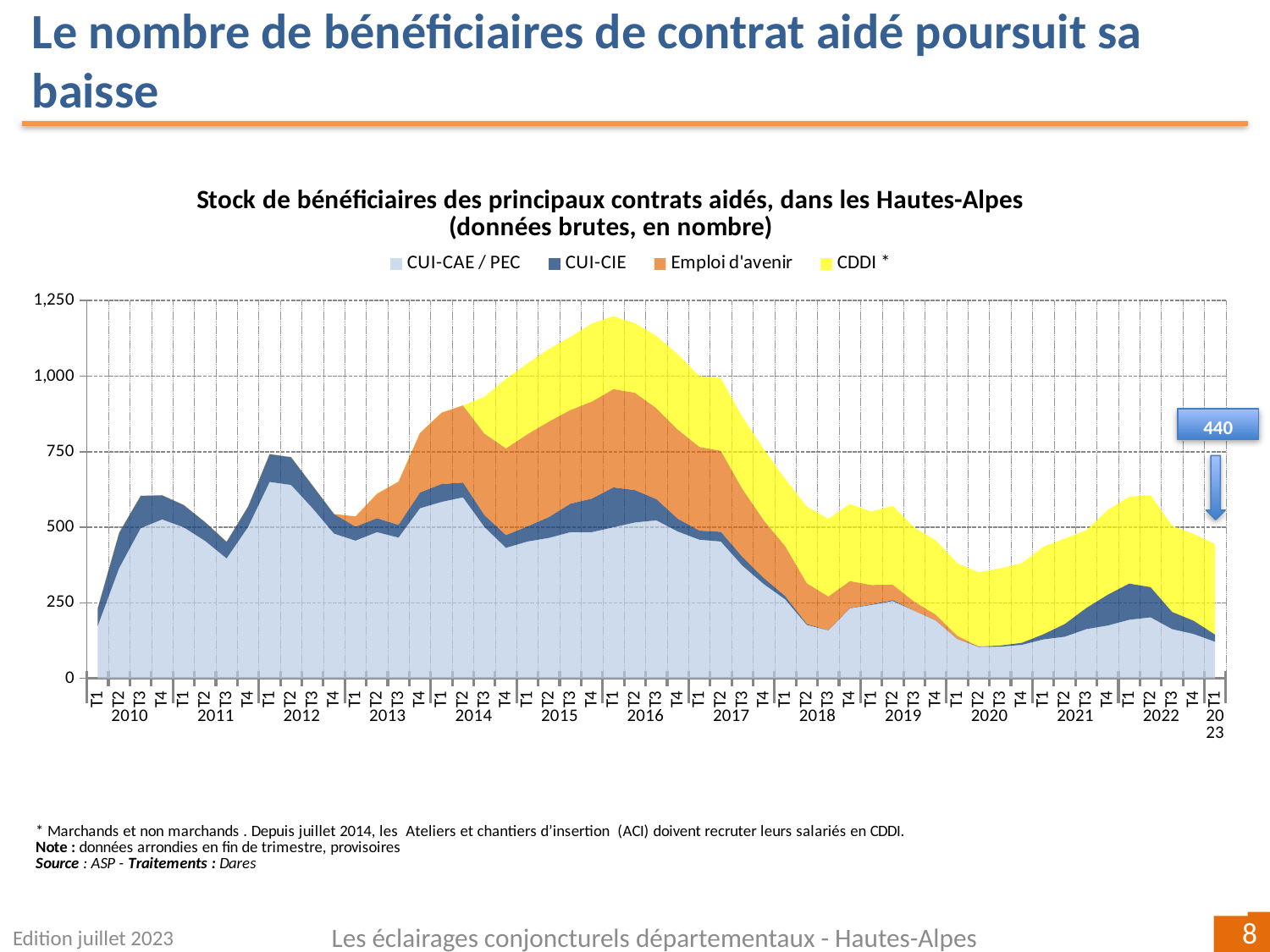
Is the total stock of beneficiaries at T1 2012 greater or less than 500? greater Which colour represents the CDDI * series in the legend? yellow How many years are labelled along the x axis? 14 What kind of chart is shown on the slide? stacked area chart Between 2016 and 2020, does the total stock of beneficiaries rise or fall? fall Which is larger, the total stock at T1 2012 or at T1 2019? T1 2012 What total value is labelled on the chart for T1 2023? 440 Is the total stock of beneficiaries at T2 2020 greater or less than 250? greater Is the total stock of beneficiaries at T1 2016 greater or less than 1,000? greater In which year does the total stock of beneficiaries reach its highest level? 2016 How many series does the legend list? 4